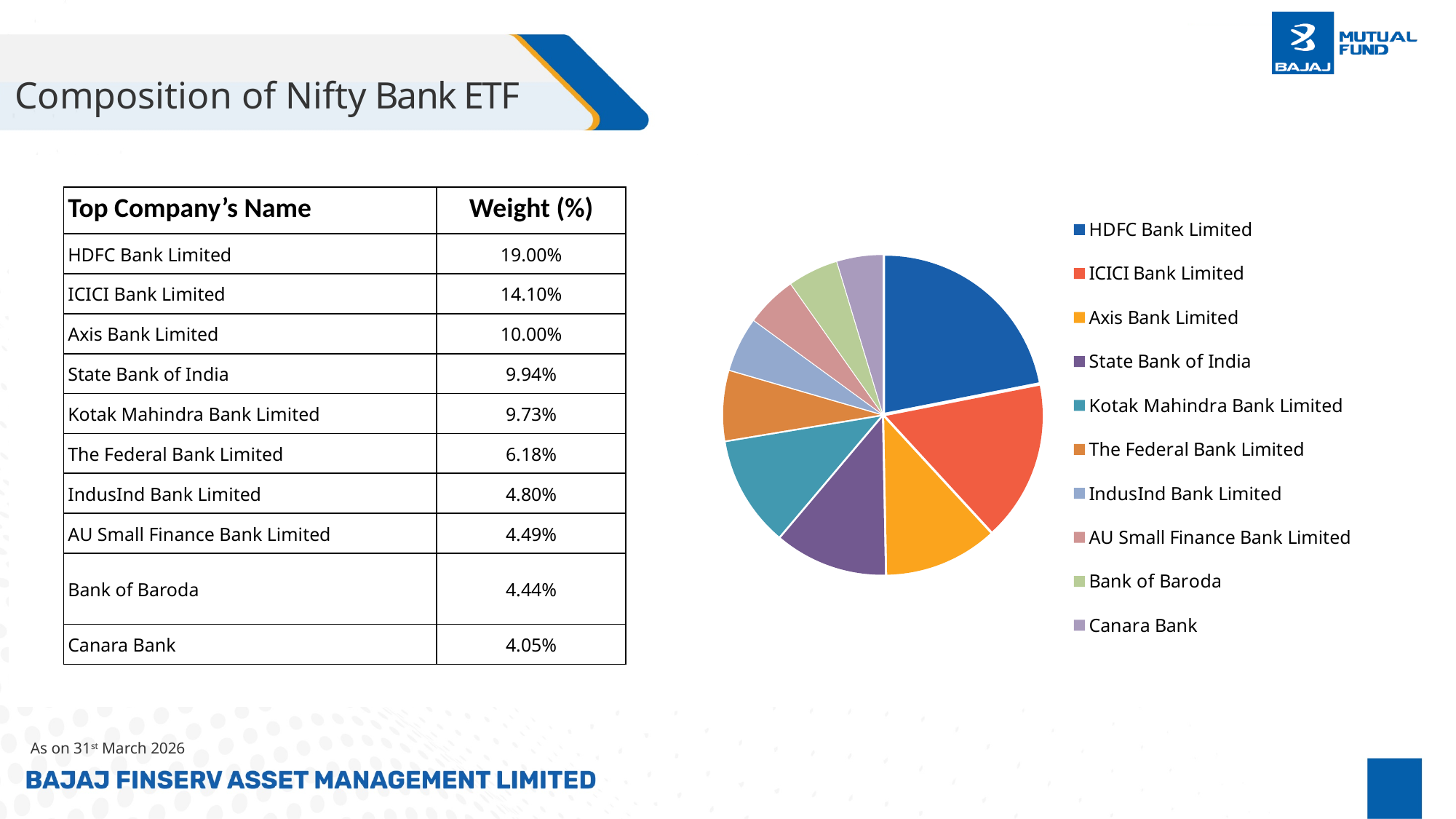
What is the weight of Kotak Mahindra Bank Limited? 9.73% Which has a larger slice of the pie chart, The Federal Bank Limited or IndusInd Bank Limited? The Federal Bank Limited What is the weight of HDFC Bank Limited? 19.00% How many companies are listed in the pie chart's legend? 10 What is the weight of Bank of Baroda? 4.44% Which has a larger slice of the pie chart, ICICI Bank Limited or Axis Bank Limited? ICICI Bank Limited Which company is listed first in the pie chart's legend? HDFC Bank Limited Which company has the largest slice of the pie chart? HDFC Bank Limited What kind of chart is shown on the slide? Pie chart What is the difference in weight between HDFC Bank Limited and ICICI Bank Limited? 4.90% Which company has the smallest slice of the pie chart? Canara Bank What colour is the slice for Axis Bank Limited in the pie chart? Orange/yellow